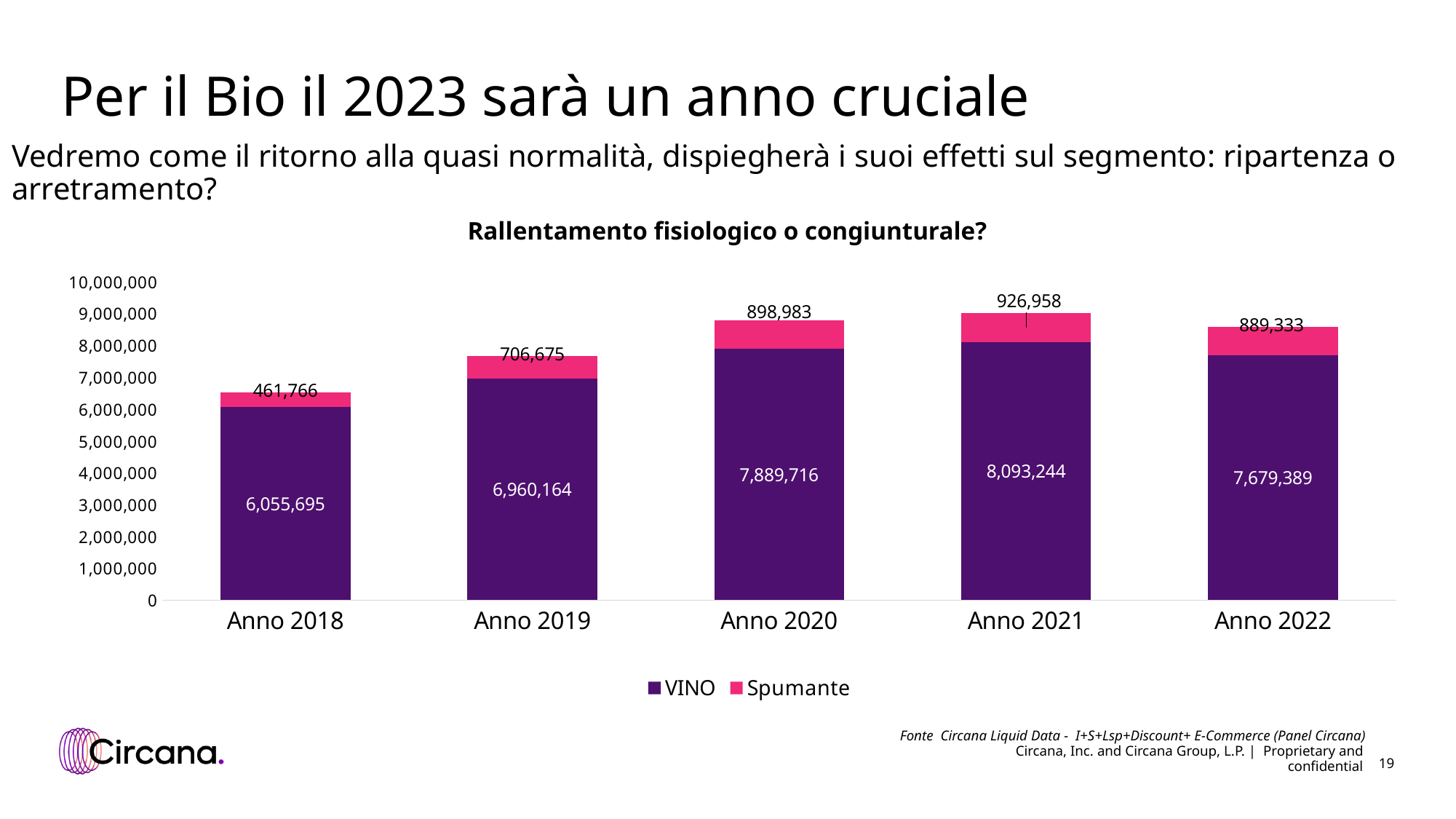
How many years are shown on the x axis? 5 Which year has the highest VINO value? Anno 2021 What kind of chart is shown? Stacked bar chart What is the difference between the VINO values for Anno 2021 and Anno 2020? 203,528 What is the Spumante value for Anno 2018? 461,766 What is the VINO value for Anno 2021? 8,093,244 What is the VINO value for Anno 2022? 7,679,389 Which is larger, the Spumante value for Anno 2020 or for Anno 2022? Anno 2020 What is the title of the chart? Rallentamento fisiologico o congiunturale? How many series does the legend list? 2 What is the total of the stacked bar for Anno 2019? 7,666,839 Which year has the lowest Spumante value? Anno 2018